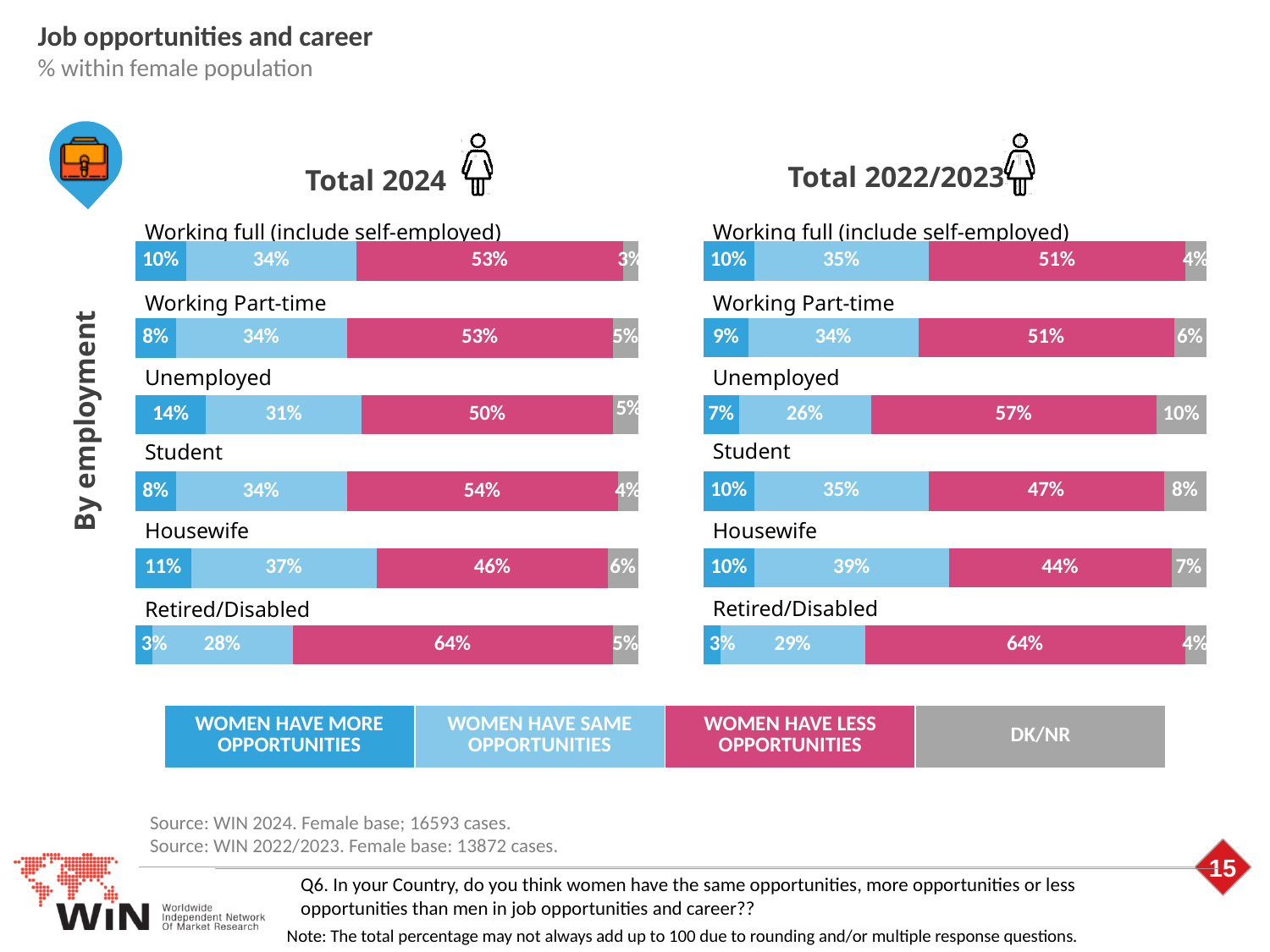
How many response categories does the legend list? 4 In the Total 2022/2023 chart, what is the difference between the 'women have less opportunities' values for Unemployed and Housewife? 13 percentage points In the Total 2024 chart, which has a larger 'women have more opportunities' value: Unemployed or Student? Unemployed In the Total 2022/2023 chart, what is the DK/NR value for the Unemployed category? 10% In the Total 2024 chart, which employment category has the highest share saying women have less opportunities? Retired/Disabled In the Total 2024 chart, what is the total of the Working full (include self-employed) bar? 100% In the Total 2022/2023 chart, which employment category has the highest share saying women have the same opportunities? Housewife In the Total 2024 chart, which employment category has the lowest share saying women have more opportunities? Retired/Disabled In the Total 2024 chart, what percentage of housewives say women have less opportunities? 46% What kind of chart is used to show the Total 2024 data? Stacked bar chart How many employment categories are shown in the Total 2024 chart? 6 According to the legend, what does the grey segment of each bar represent? DK/NR